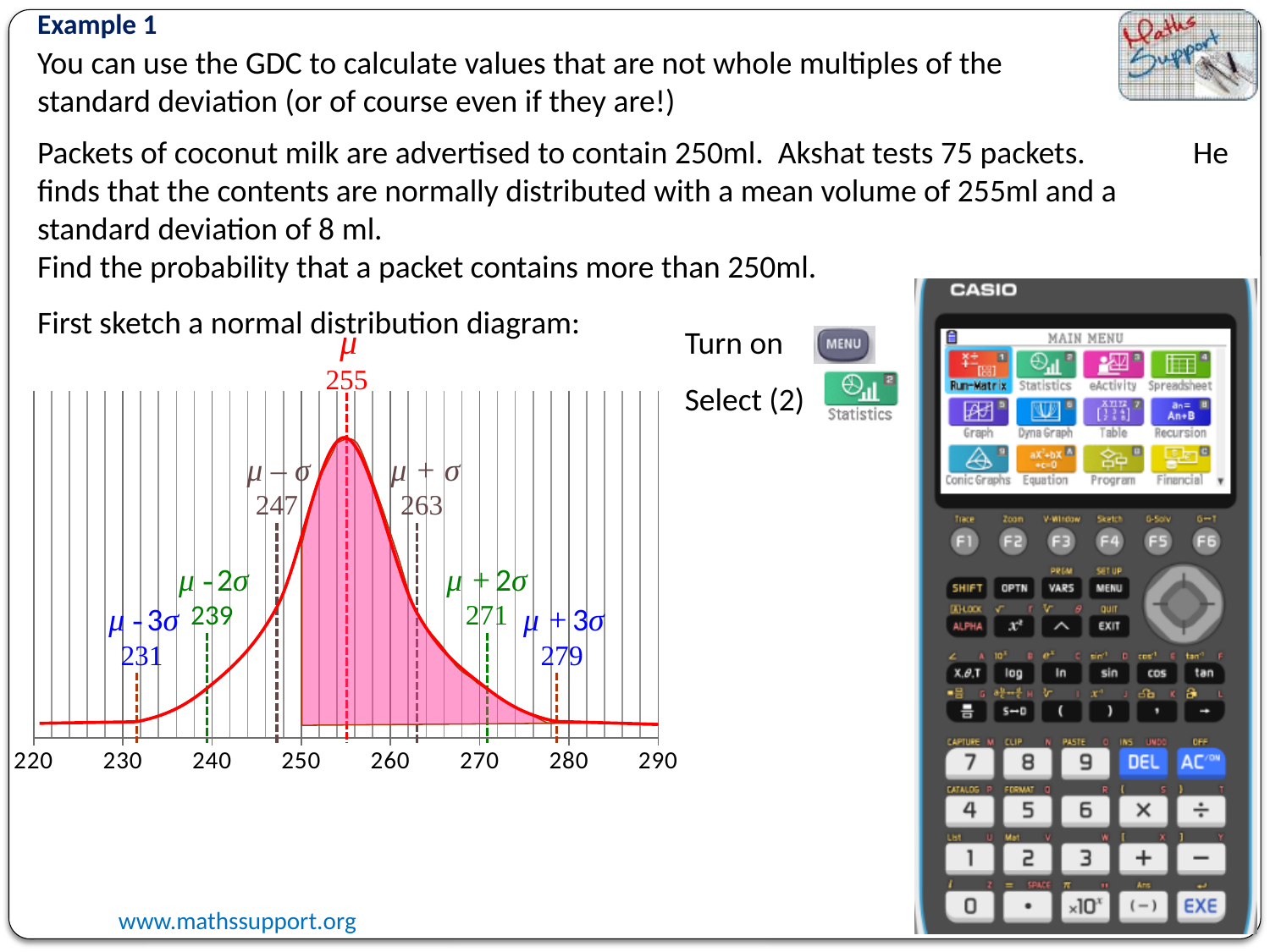
On the normal distribution diagram, from which x-axis value does the shaded region begin? 250 On the normal distribution diagram, what value is labelled at μ + 3σ? 279 On the normal distribution diagram, what value is labelled at the mean μ? 255 On the normal distribution diagram, what is the difference between the values labelled at μ + σ and μ − σ? 16 On the normal distribution diagram, what value is labelled at μ + 2σ? 271 On the normal distribution diagram, what are the lowest and highest values shown on the horizontal axis? 220 and 290 On the normal distribution diagram, what is the difference between the values labelled at μ + 3σ and μ? 24 On the normal distribution diagram, what value is labelled at μ − 2σ? 239 On the normal distribution diagram, what value is labelled at μ − 3σ? 231 On the normal distribution diagram, what value is labelled at μ − σ? 247 On the normal distribution diagram, what value is labelled at μ + σ? 263 On the normal distribution diagram, which is larger: the value labelled at μ + 2σ or the value labelled at μ + σ? μ + 2σ